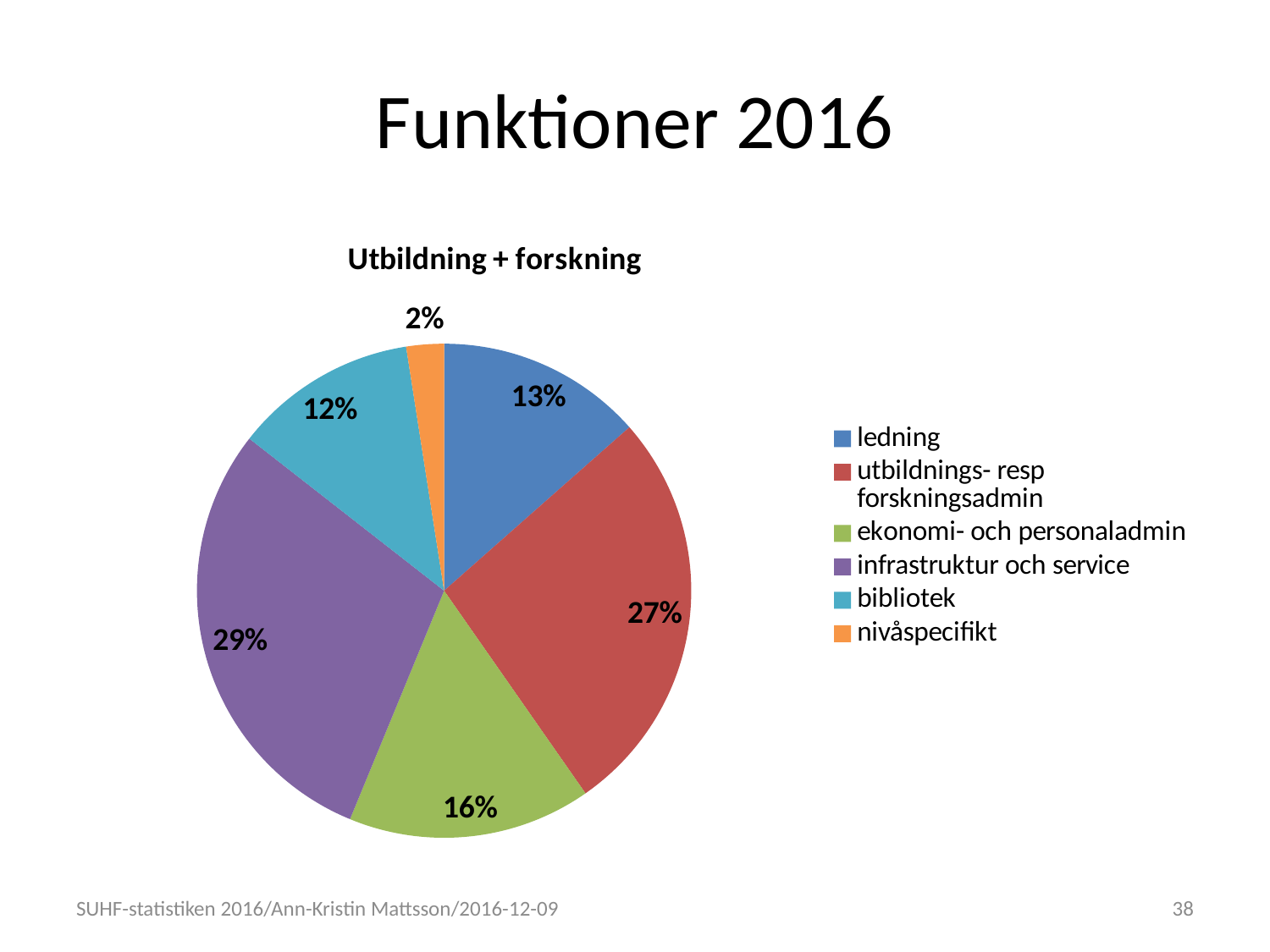
Which category has the largest slice? infrastruktur och service Which category has the smallest slice? nivåspecifikt What type of chart is shown on the slide? pie chart What is the difference between the shares of utbildnings- resp forskningsadmin and ledning? 14% What is the chart's title? Utbildning + forskning What share of the pie does ledning have? 13% How many categories does the pie chart have? 6 What share of the pie does utbildnings- resp forskningsadmin have? 27% What share of the pie does bibliotek have? 12% What share of the pie does nivåspecifikt have? 2% What share of the pie does infrastruktur och service have? 29% What share of the pie does ekonomi- och personaladmin have? 16%